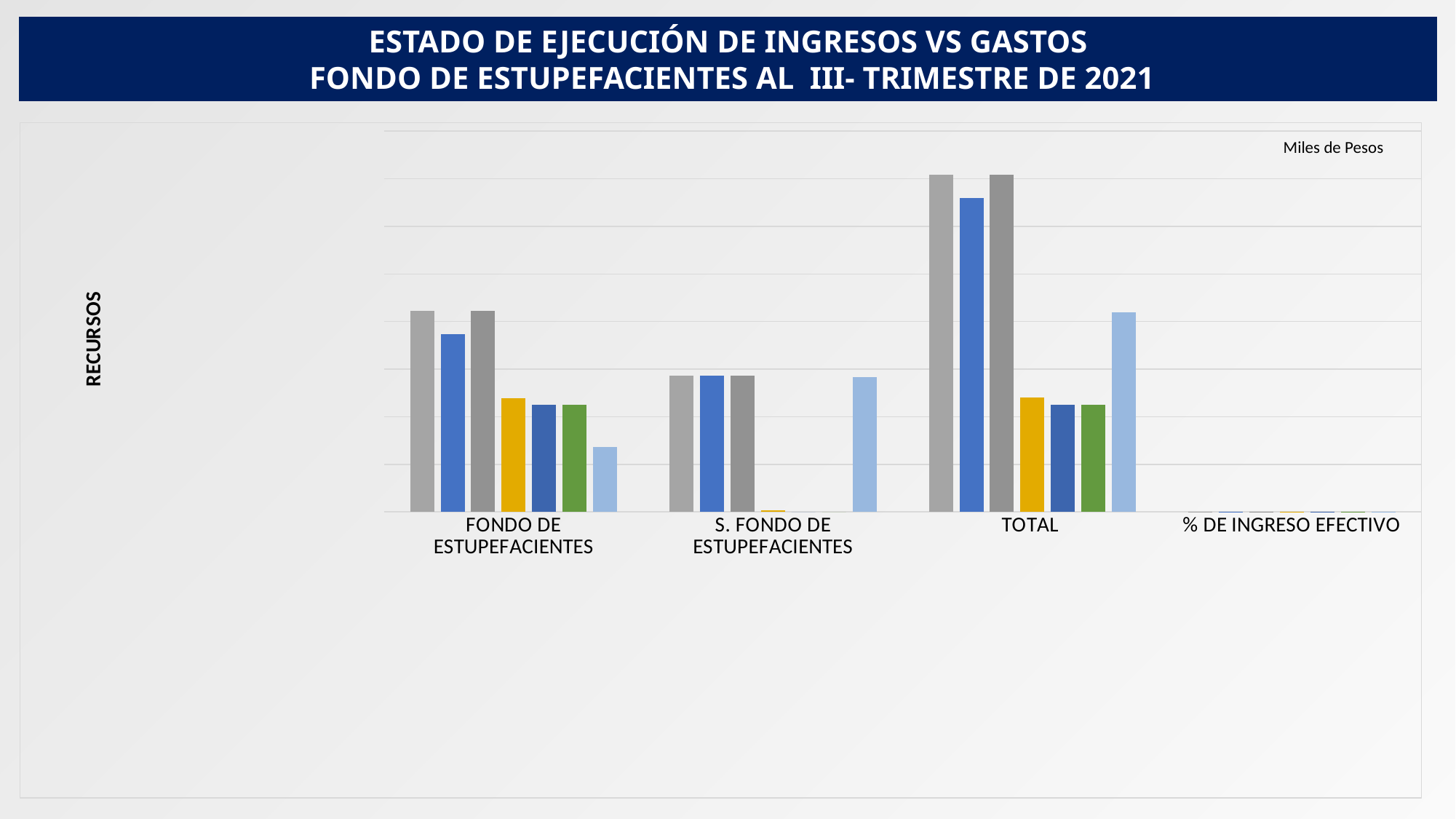
What kind of chart is shown on the slide? Bar chart Which category has the tallest bars in the chart? TOTAL Which category has the smallest bars in the chart? % DE INGRESO EFECTIVO Is the first gray bar larger for TOTAL or for FONDO DE ESTUPEFACIENTES? TOTAL How many categories are shown on the x axis of the chart? 4 In the FONDO DE ESTUPEFACIENTES group, is the first gray bar or the light blue bar larger? The first gray bar Is the light blue bar larger for TOTAL or for FONDO DE ESTUPEFACIENTES? TOTAL What unit is indicated in the top right corner of the chart? Miles de Pesos What is the title of the chart on the slide? ESTADO DE EJECUCIÓN DE INGRESOS VS GASTOS FONDO DE ESTUPEFACIENTES AL III- TRIMESTRE DE 2021 How many bars are plotted in the FONDO DE ESTUPEFACIENTES group? 7